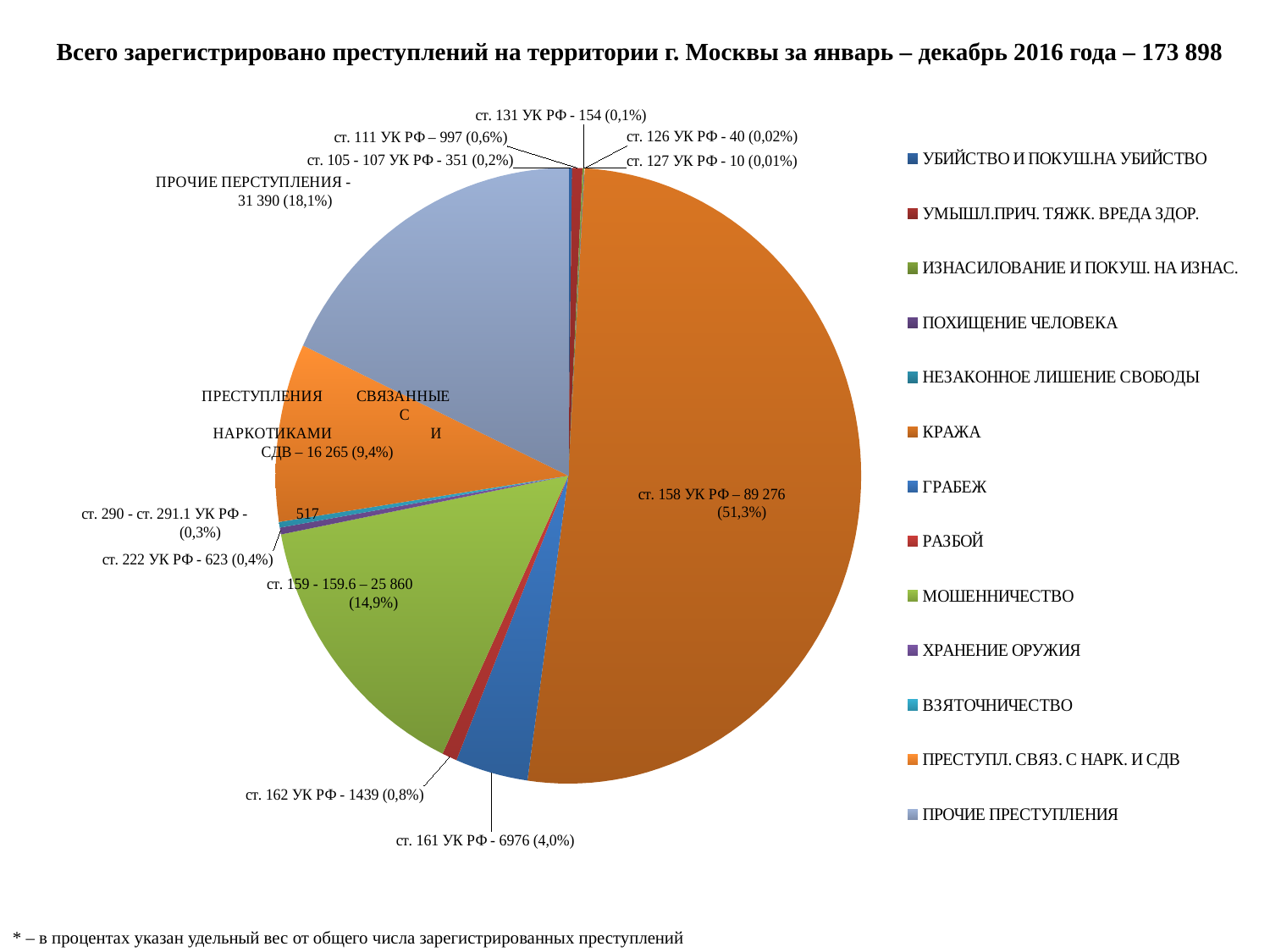
How many crimes are labelled for ст. 159 - 159.6 УК РФ? 25 860 Which category has the largest slice of the pie? ст. 158 УК РФ (КРАЖА) How many crimes are labelled for ст. 158 УК РФ? 89 276 How many categories does the legend of the pie chart list? 13 Which is larger, the value for ст. 161 УК РФ or for ст. 162 УК РФ? ст. 161 УК РФ What kind of chart is shown on the slide? pie chart What is the difference between the values for ст. 111 УК РФ and ст. 105 - 107 УК РФ? 646 What share of the pie does the ст. 158 УК РФ slice represent? 51,3% What is the total number of registered crimes stated in the chart title? 173 898 What is the difference between the values for ст. 158 УК РФ and ст. 159 - 159.6 УК РФ? 63 416 Which category has the smallest labelled value on the pie chart? ст. 127 УК РФ - 10 What share of the pie is labelled for ПРОЧИЕ ПРЕСТУПЛЕНИЯ? 18,1%